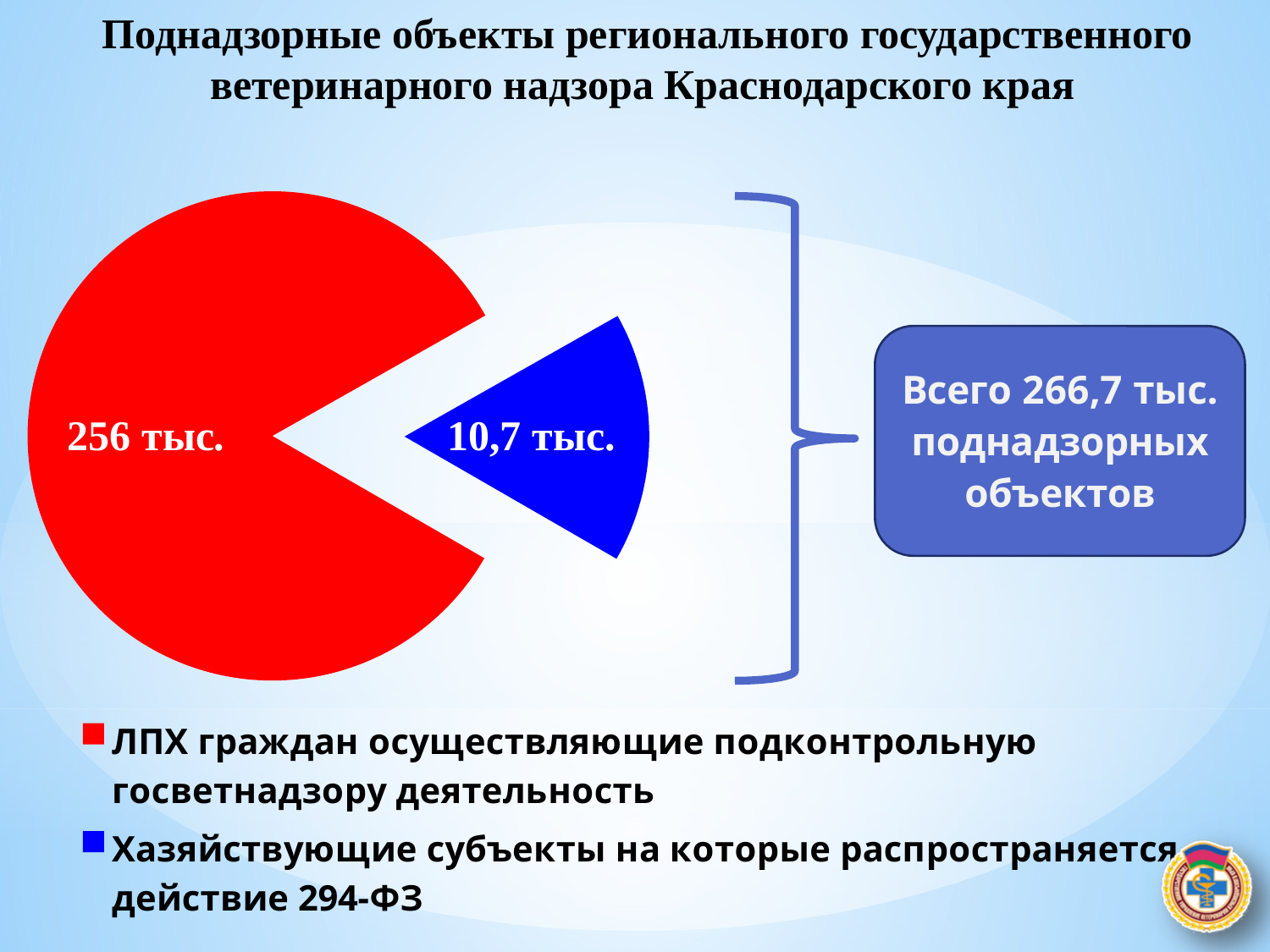
What is the total number of supervised objects stated on the slide? 266,7 тыс. What is the value of the red slice (ЛПХ граждан осуществляющие подконтрольную госветнадзору деятельность)? 256 тыс. Which category has the smallest slice of the pie? Хозяйствующие субъекты на которые распространяется действие 294-ФЗ What is the value of the blue slice (Хозяйствующие субъекты на которые распространяется действие 294-ФЗ)? 10,7 тыс. Which is larger: the slice for ЛПХ граждан or the slice for Хозяйствующие субъекты? ЛПХ граждан Which category has the largest slice of the pie? ЛПХ граждан осуществляющие подконтрольную госветнадзору деятельность What is the difference between the red slice (256 тыс.) and the blue slice (10,7 тыс.)? 245,3 тыс. How many entries does the legend list? 2 What kind of chart is shown on the slide? pie chart Approximately what share of the total (266,7 тыс.) does the blue slice (10,7 тыс.) represent, rounded to the nearest whole percent? 4% How many slices does the pie chart have? 2 What colour is the slice representing ЛПХ граждан? red